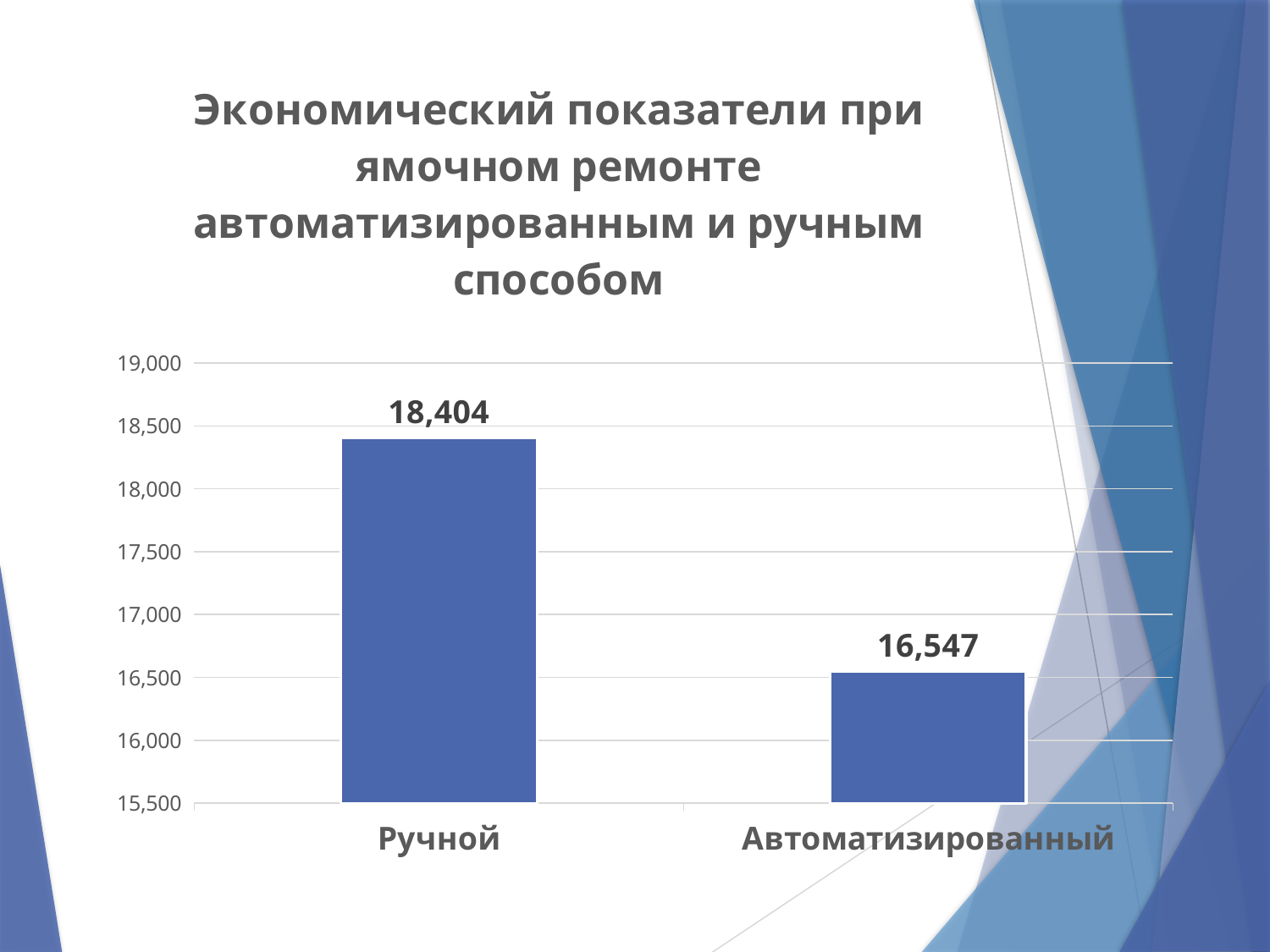
What is the value for Автоматизированный? 16,547 What is the title of the chart? Экономический показатели при ямочном ремонте автоматизированным и ручным способом How many categories are shown on the chart? 2 Which is larger, the value for Ручной or the value for Автоматизированный? Ручной Is the value for Ручной greater or less than 18,000? greater Do the values rise or fall from Ручной to Автоматизированный? fall Which category has the lowest value? Автоматизированный What kind of chart is shown on the slide? bar chart What is the difference between the values for Ручной and Автоматизированный? 1,857 Is the value for Автоматизированный greater or less than 17,000? less Which category has the highest value? Ручной What is the value for Ручной? 18,404